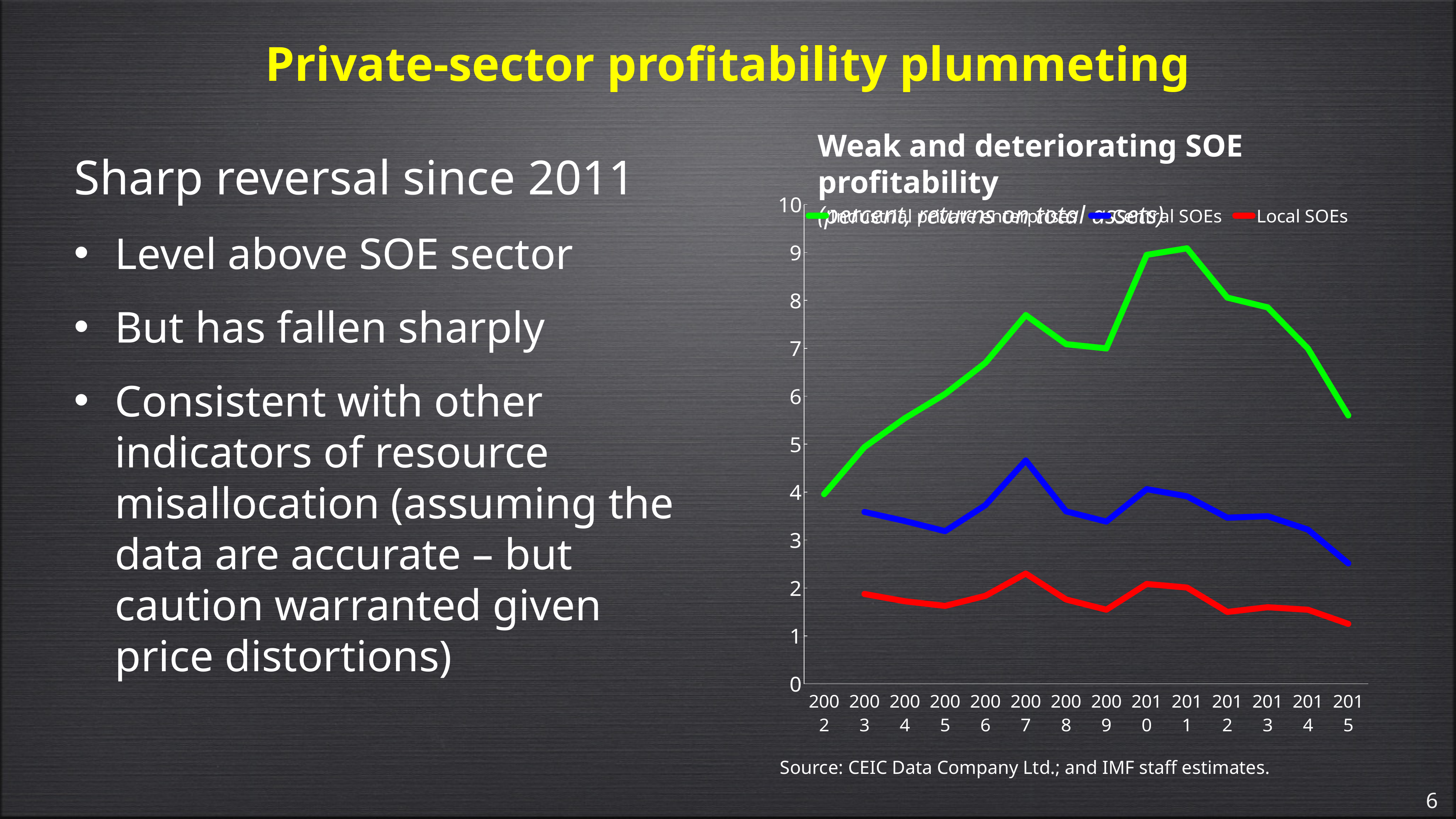
Which is higher in 2010, the Central SOEs line or the Local SOEs line? Central SOEs In which year is the Local SOEs line at its lowest value? 2015 Is the value of the green line in 2015 greater or less than 5? greater In which year does the Central SOEs line reach its highest value? 2007 Is the value for Local SOEs in 2015 greater or less than 2? less What kind of chart is shown on the slide? line chart In which year does the green line reach its highest value? 2011 Is the value for Central SOEs in 2015 greater or less than 3? less Does the green line rise or fall between 2011 and 2015? fall How many years are shown on the x axis of the chart? 14 What colour is the Local SOEs line in the chart? red How many series does the chart legend list? 3